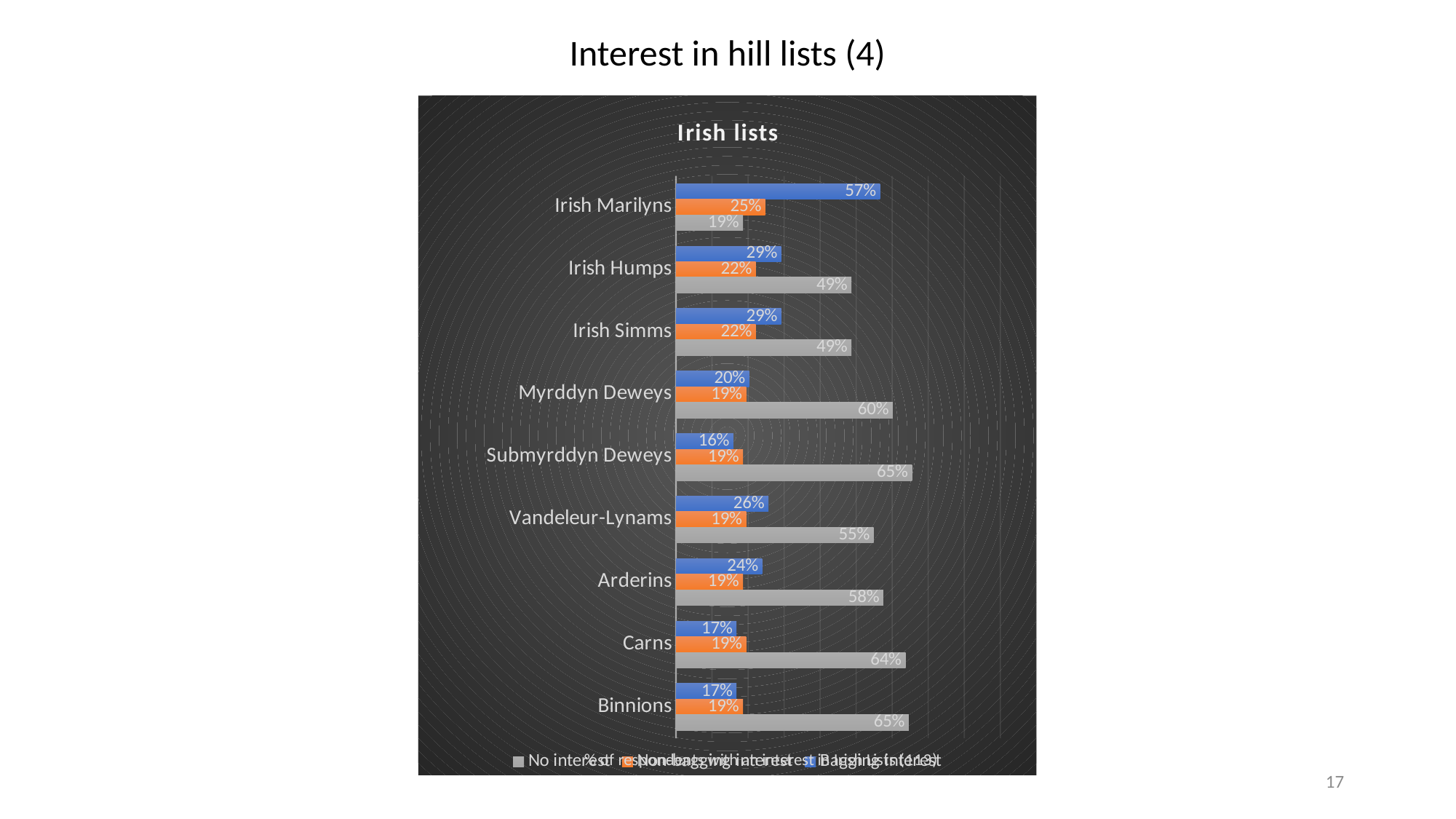
What is the value of the grey bar for Vandeleur-Lynams? 55% Which list has the lowest value for the grey bar? Irish Marilyns What is the value of the blue bar for Irish Marilyns? 57% What is the difference between the blue bar and the orange bar for Irish Marilyns? 32 percentage points How many series does the legend list? 3 What is the value of the orange bar for Irish Humps? 22% Which list has the highest value for the blue bar? Irish Marilyns What is the value of the grey bar for Myrddyn Deweys? 60% What kind of chart is shown on the slide? bar chart How many Irish lists (categories) are shown on the chart? 9 Which list has the lowest value for the blue bar? Submyrddyn Deweys What is the title of the chart? Irish lists